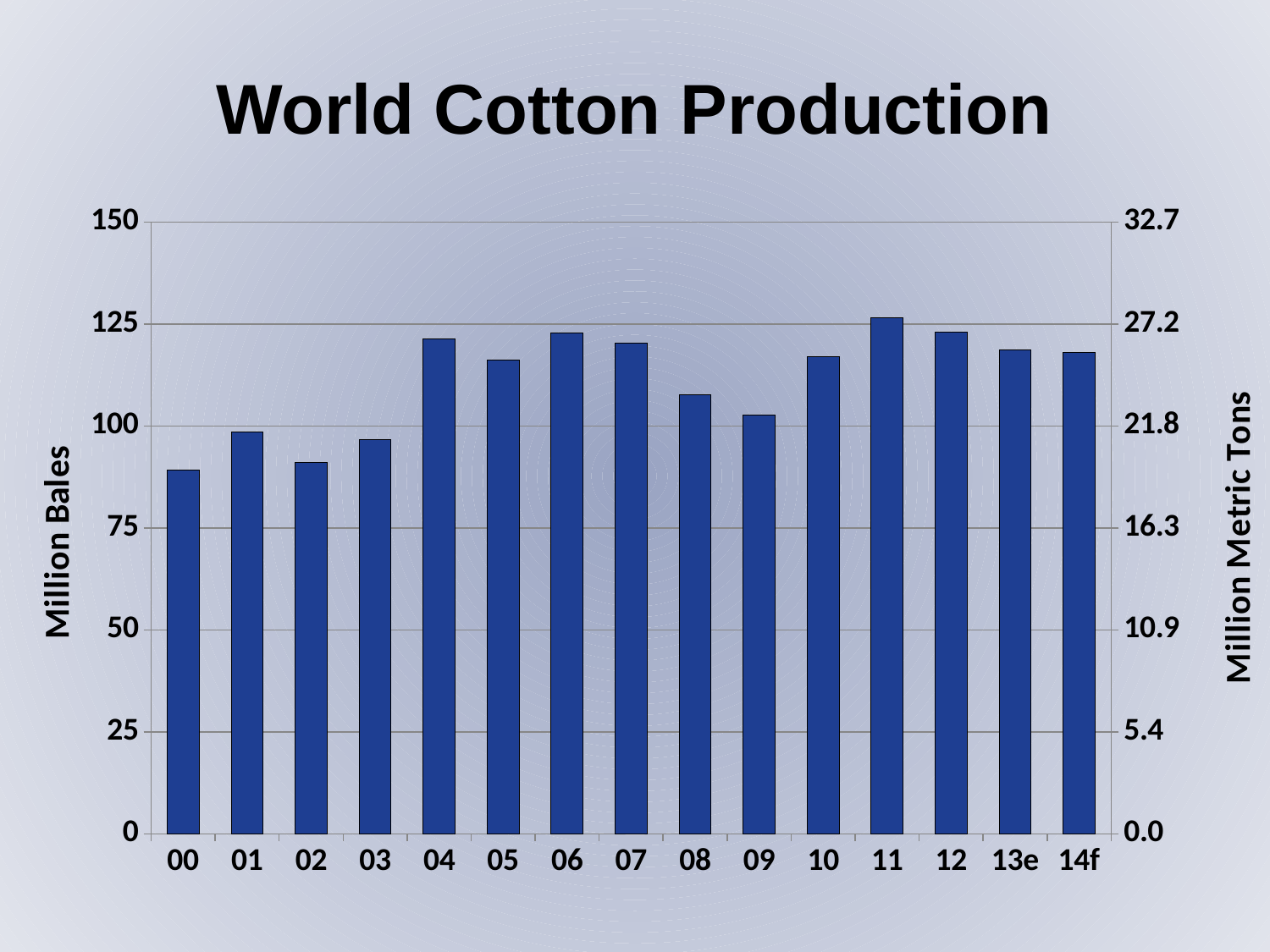
Which is larger, the value for 07 or the value for 08? 07 What kind of chart is shown on the slide? bar chart Is the value for 00 greater or less than 100 million bales? less What is the label on the left vertical axis? Million Bales What is the title of the chart? World Cotton Production Is the value for 08 greater or less than 100 million bales? greater Is the value for 02 greater or less than 100 million bales? less Which year has the highest world cotton production? 11 Which is larger, the value for 03 or the value for 04? 04 Do the values rise or fall from 06 to 09? fall How many years (bars) are shown on the x axis? 15